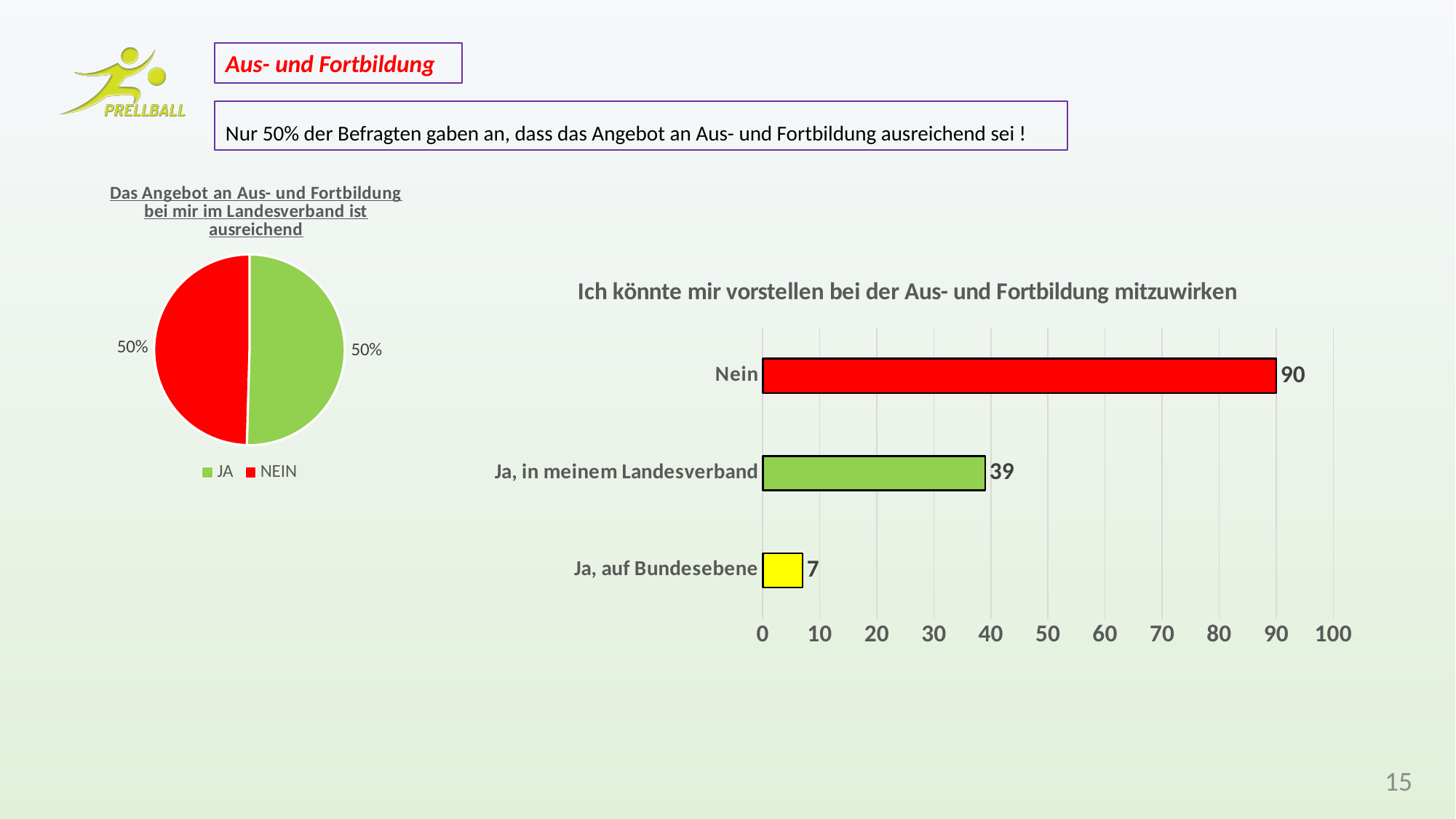
In the bar chart 'Ich könnte mir vorstellen bei der Aus- und Fortbildung mitzuwirken', what is the value for 'Ja, in meinem Landesverband'? 39 How many entries does the legend of the pie chart on the left list? 2 In the bar chart 'Ich könnte mir vorstellen bei der Aus- und Fortbildung mitzuwirken', which category has the lowest value? Ja, auf Bundesebene In the bar chart 'Ich könnte mir vorstellen bei der Aus- und Fortbildung mitzuwirken', what is the value for 'Ja, auf Bundesebene'? 7 What kind of chart is the chart on the right of the slide? Bar chart In the bar chart 'Ich könnte mir vorstellen bei der Aus- und Fortbildung mitzuwirken', what is the difference between the values for 'Nein' and 'Ja, in meinem Landesverband'? 51 In the bar chart 'Ich könnte mir vorstellen bei der Aus- und Fortbildung mitzuwirken', what is the value for 'Nein'? 90 How many categories does the bar chart 'Ich könnte mir vorstellen bei der Aus- und Fortbildung mitzuwirken' show? 3 In the pie chart 'Das Angebot an Aus- und Fortbildung bei mir im Landesverband ist ausreichend', what share does 'JA' have? 50% In the pie chart 'Das Angebot an Aus- und Fortbildung bei mir im Landesverband ist ausreichend', what share does 'NEIN' have? 50% In the bar chart 'Ich könnte mir vorstellen bei der Aus- und Fortbildung mitzuwirken', which is larger: 'Ja, in meinem Landesverband' or 'Ja, auf Bundesebene'? Ja, in meinem Landesverband In the bar chart 'Ich könnte mir vorstellen bei der Aus- und Fortbildung mitzuwirken', which category has the highest value? Nein